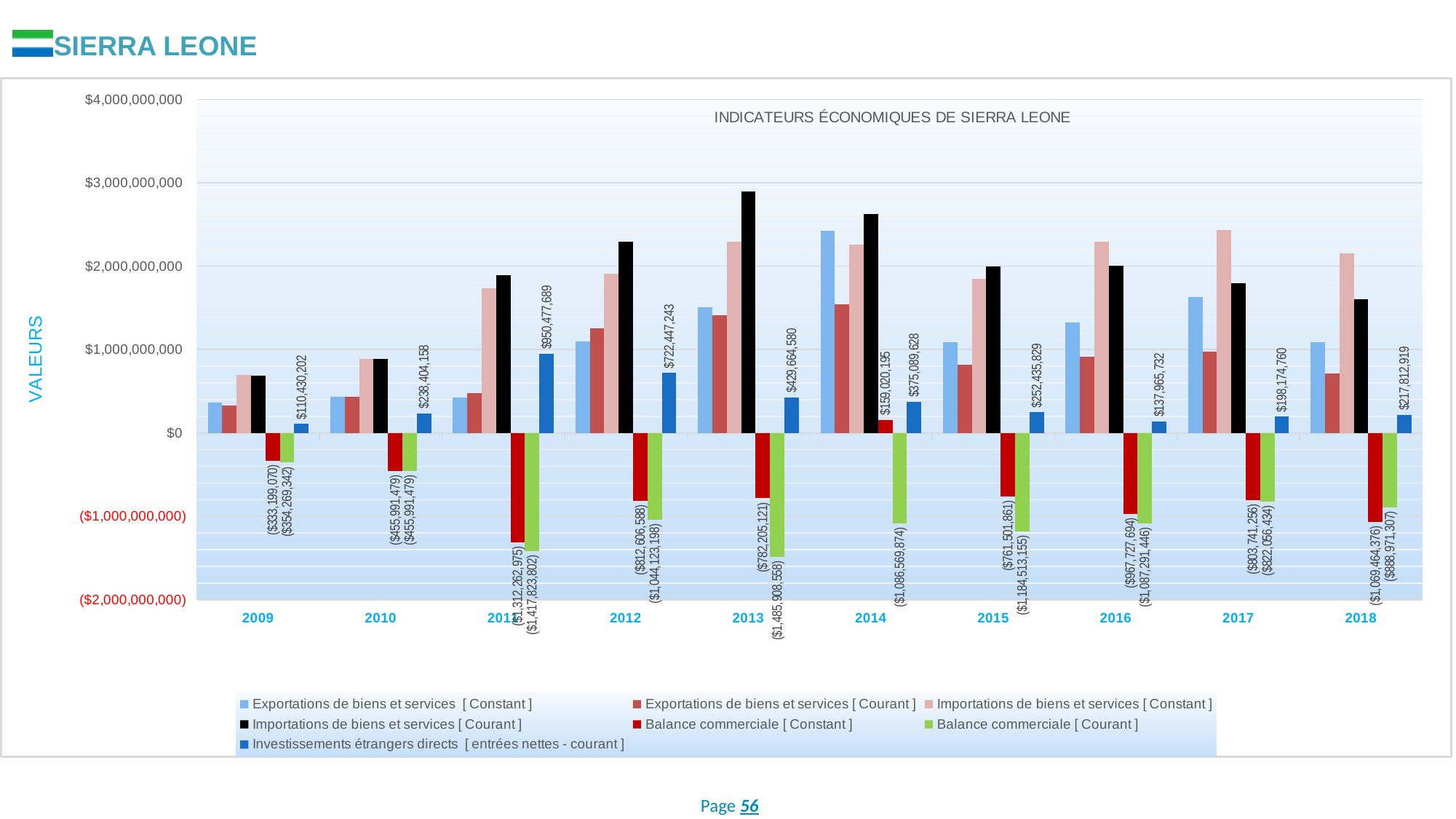
Is the value of Exportations de biens et services [Constant] for 2014 greater or less than $2,000,000,000? greater What is the difference between Investissements étrangers directs in 2011 and 2012? $228,030,446 What is the value of Investissements étrangers directs for 2011? $950,477,689 In which year is Investissements étrangers directs highest? 2011 What is the title of the chart? INDICATEURS ÉCONOMIQUES DE SIERRA LEONE How many series does the legend list? 7 How many years are shown on the x axis? 10 Which year has the larger value for Importations de biens et services [Courant], 2013 or 2014? 2013 What kind of chart is shown on the slide? bar chart What is the value of Balance commerciale [Constant] for 2014? $159,020,195 What is the value of Balance commerciale [Courant] for 2013? ($1,485,908,558) In which year is Investissements étrangers directs lowest? 2009